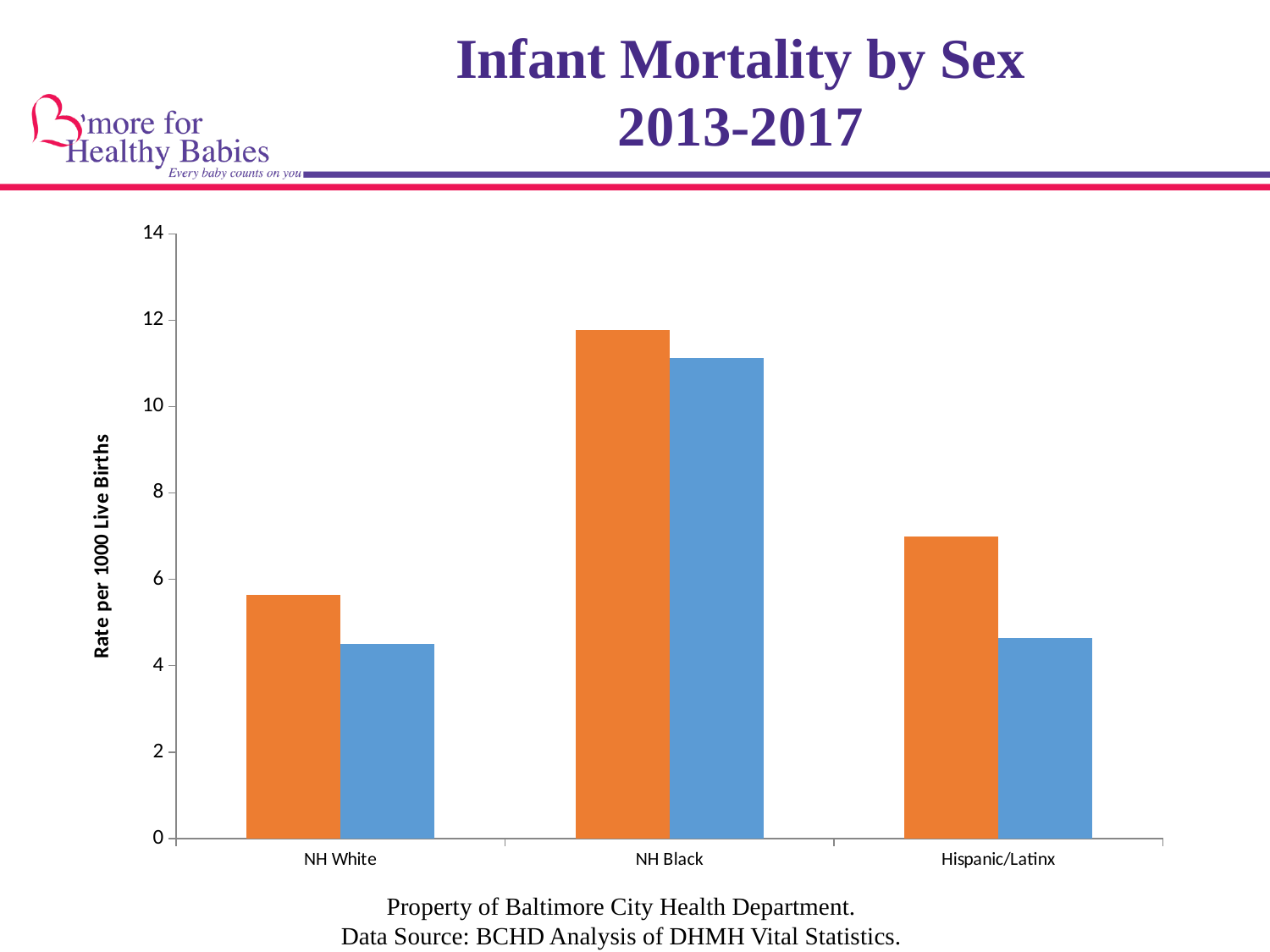
How many categories are shown on the x axis? 3 Is the blue bar for Hispanic/Latinx greater or less than 6? less For NH White, which bar is taller, the orange bar or the blue bar? orange What is the label on the vertical axis? Rate per 1000 Live Births For Hispanic/Latinx, which bar is taller, the orange bar or the blue bar? orange Is the orange bar for NH Black greater or less than 10? greater Which category has the highest blue bar? NH Black Is the blue bar for NH White greater or less than 6? less Which category has the lowest orange bar? NH White What kind of chart is shown on the slide? bar chart Which category has the highest orange bar? NH Black